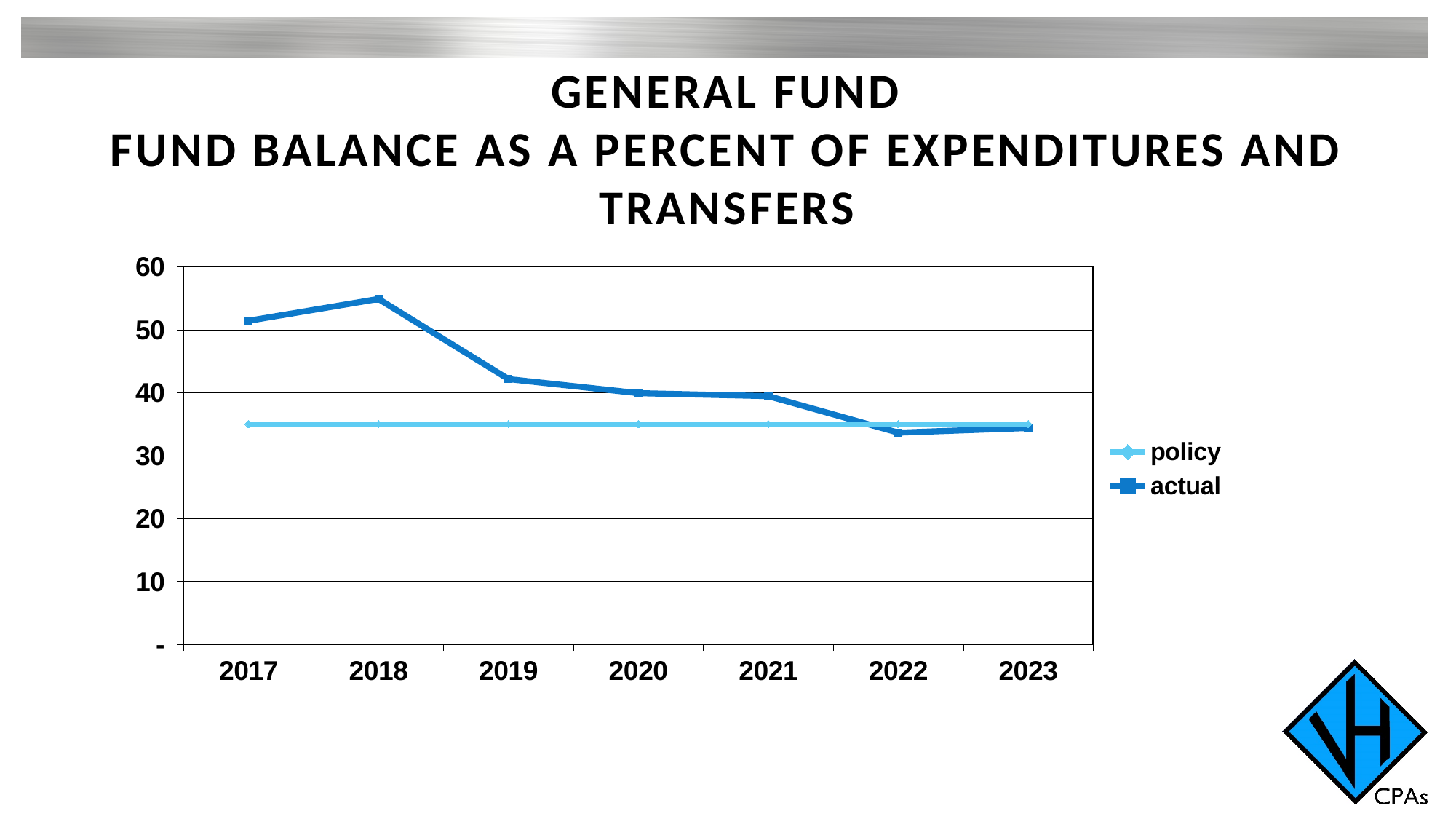
Does the actual series generally rise or fall from 2017 to 2023? fall Is the actual value for 2017 greater or less than 40? greater Is the actual value for 2022 greater or less than 40? less Is the actual value for 2019 greater or less than 40? greater In 2018, which series has the higher value, policy or actual? actual Which is larger, the actual value for 2017 or the actual value for 2019? 2017 What kind of chart is shown on the slide? line chart How many years are shown on the x axis? 7 How many series does the legend list? 2 What are the two series named in the legend? policy and actual In which year is the actual series at its highest? 2018